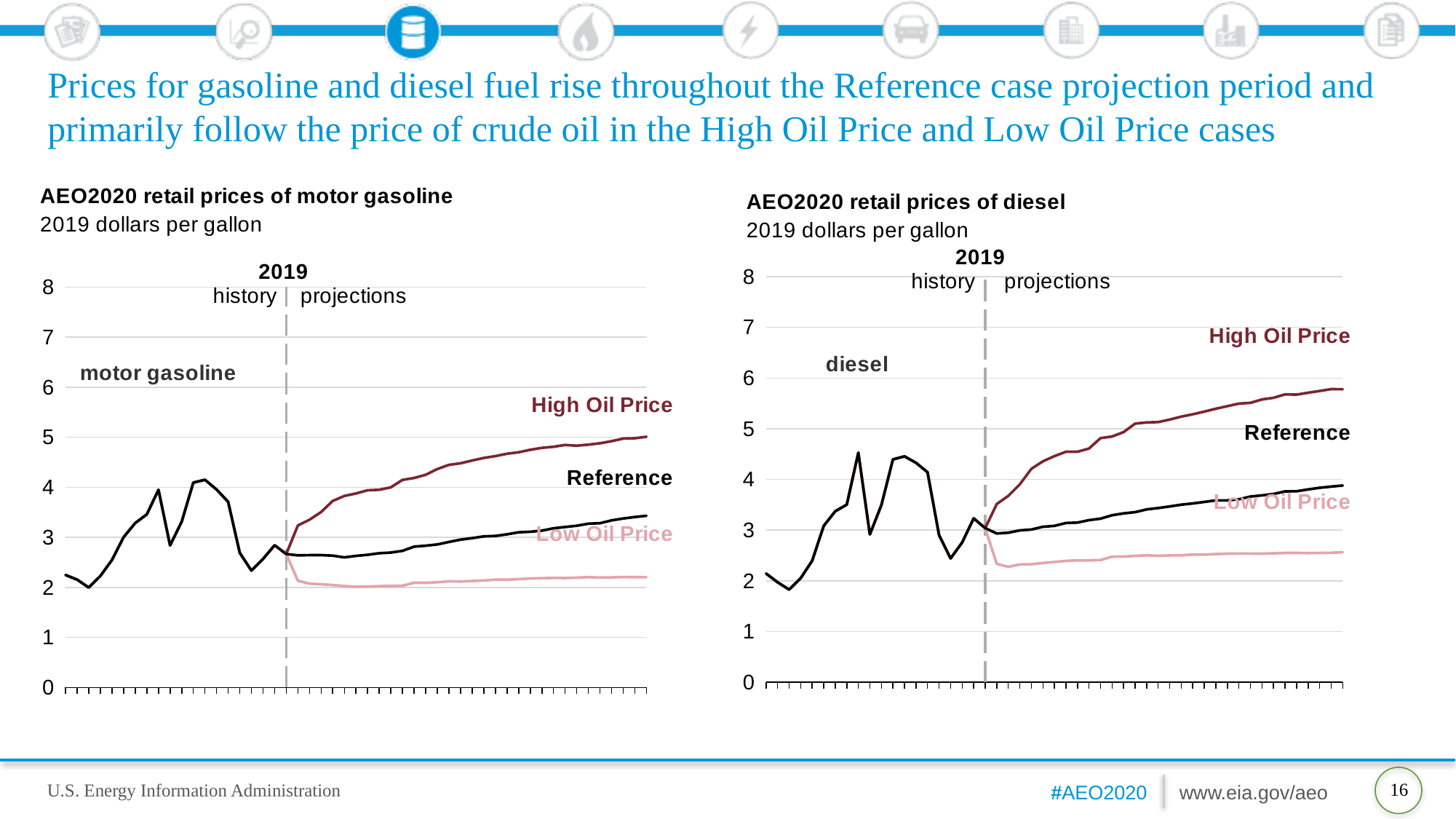
In the 'AEO2020 retail prices of diesel' chart, is the Low Oil Price value at the end of the projection period greater or less than 3? less What unit is used on the y axis of the 'AEO2020 retail prices of motor gasoline' chart? 2019 dollars per gallon In the 'AEO2020 retail prices of diesel' chart, which labelled case has the highest price at the end of the projection period? High Oil Price In the 'AEO2020 retail prices of motor gasoline' chart, how many projection cases are labelled? 3 In the 'AEO2020 retail prices of motor gasoline' chart, is the High Oil Price value at the end of the projection period greater or less than 4? greater What kind of chart is the 'AEO2020 retail prices of motor gasoline' chart? line chart In the 'AEO2020 retail prices of diesel' chart, does the Reference case price rise or fall over the projection period? rise In the 'AEO2020 retail prices of motor gasoline' chart, is the Reference case price at the end of the projection period higher or lower than the Low Oil Price case? higher In the 'AEO2020 retail prices of diesel' chart, is the High Oil Price value at the end of the projection period greater or less than 5? greater In the 'AEO2020 retail prices of diesel' chart, which year separates history from projections? 2019 What kind of chart is the 'AEO2020 retail prices of diesel' chart? line chart In the 'AEO2020 retail prices of motor gasoline' chart, which labelled case has the lowest price at the end of the projection period? Low Oil Price